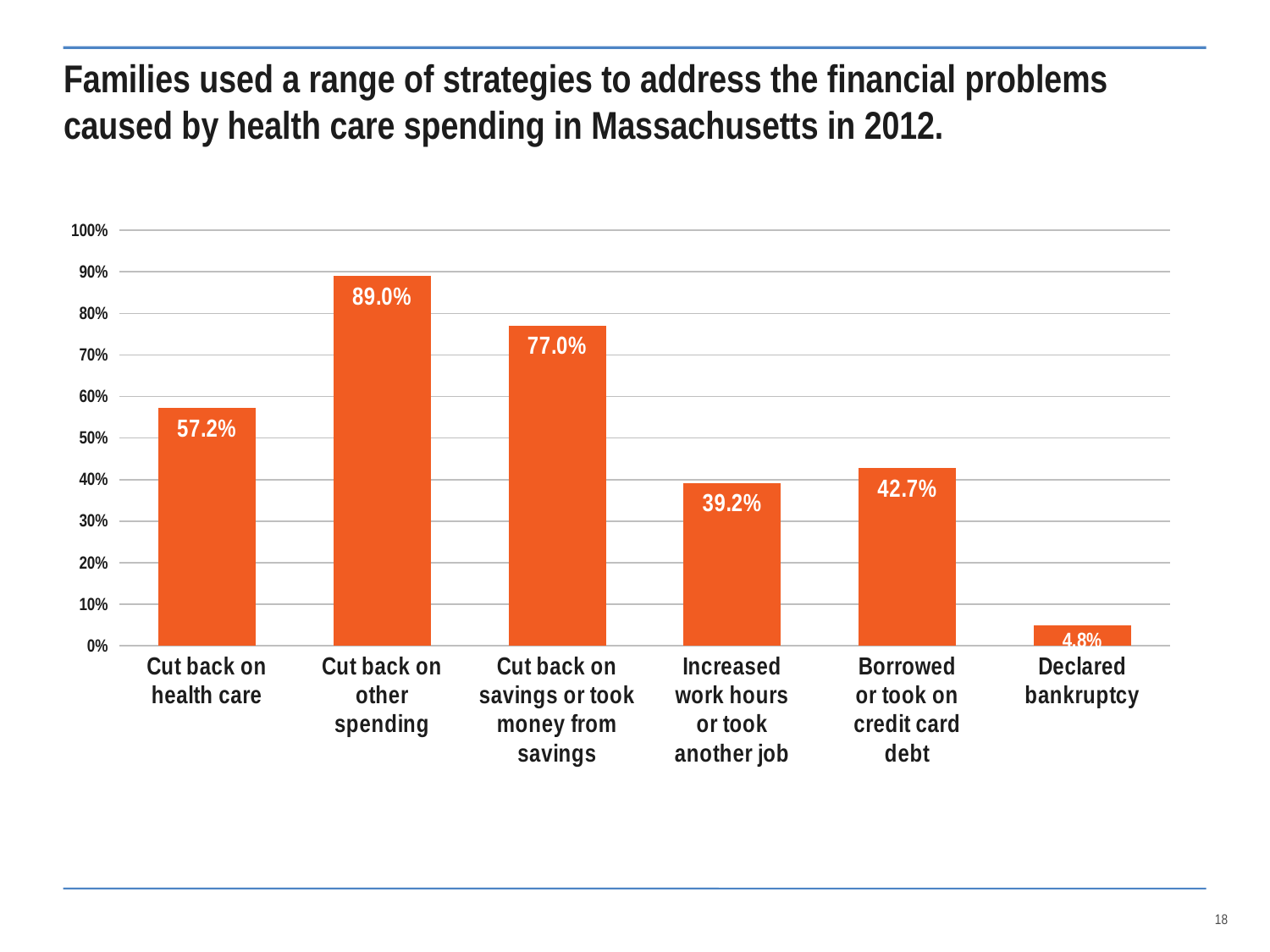
What percentage of families borrowed or took on credit card debt? 42.7% How many strategies are shown in the chart? 6 What percentage of families increased work hours or took another job? 39.2% Which strategy has the lowest percentage? Declared bankruptcy What kind of chart is shown on the slide? Bar chart Which strategy has the highest percentage? Cut back on other spending What is the difference between the percentage that cut back on other spending and the percentage that cut back on health care? 31.8% Is the value for Declared bankruptcy greater or less than 10%? less What percentage of families cut back on health care? 57.2% What percentage of families cut back on savings or took money from savings? 77.0% What percentage of families cut back on other spending? 89.0% Which is larger: the percentage that borrowed or took on credit card debt, or the percentage that increased work hours or took another job? Borrowed or took on credit card debt